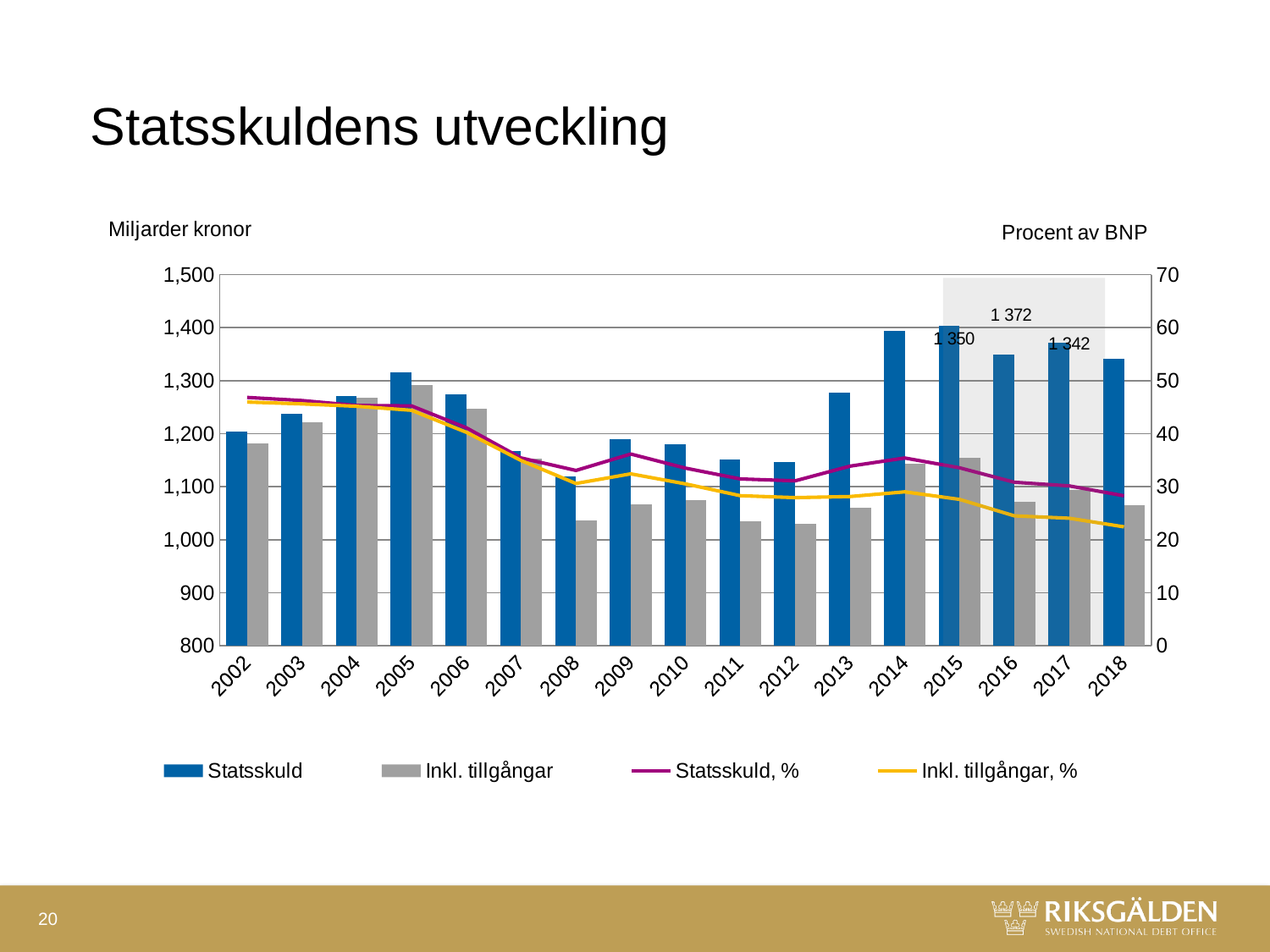
Is the Inkl. tillgångar, % value for 2018 greater or less than 30? less Is the Statsskuld value for 2013 greater or less than 1,200? greater Which year has the highest Inkl. tillgångar bar? 2005 Is the Statsskuld, % value for 2002 greater or less than 40? greater What kind of chart is shown on the slide? A combined bar and line chart What is the label of the left vertical axis? Miljarder kronor How many series does the legend list? 4 How many years are shown on the x axis? 17 Does the Statsskuld, % line rise or fall from 2002 to 2008? fall Which is larger, the Statsskuld bar for 2012 or for 2013? 2013